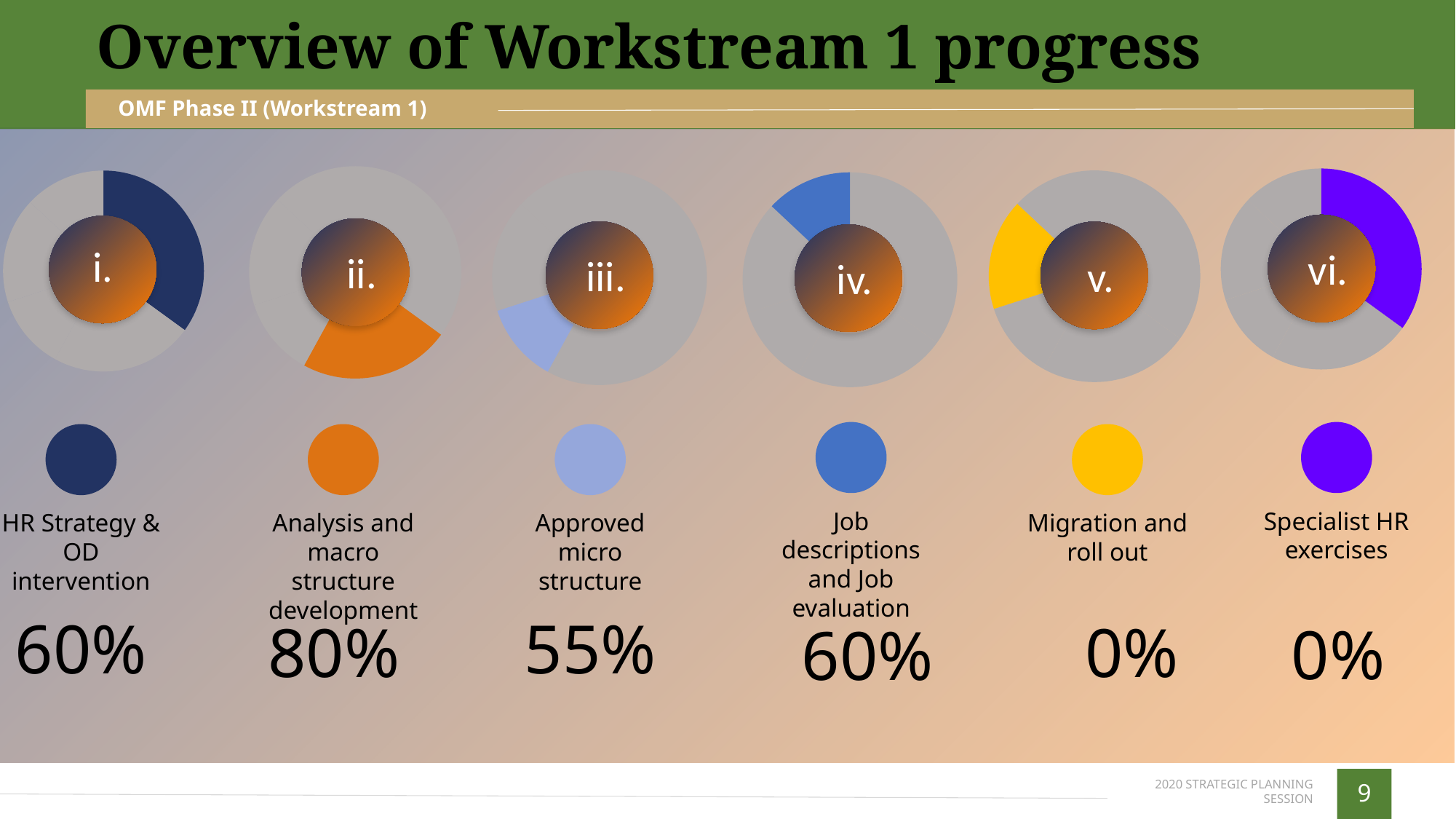
What colour is the marker for Migration and roll out? Yellow What progress percentage is shown for HR Strategy & OD intervention? 60% What progress percentage is shown for Analysis and macro structure development? 80% What progress percentage is shown for Migration and roll out? 0% What kind of chart is used to show each item's progress? Donut chart How many workstream items are shown on the slide? 6 Which workstream item has the highest progress percentage? Analysis and macro structure development What progress percentage is shown for Job descriptions and Job evaluation? 60% What is the difference between the progress percentages for Analysis and macro structure development and Approved micro structure? 25% Which has a higher progress percentage, HR Strategy & OD intervention or Approved micro structure? HR Strategy & OD intervention What progress percentage is shown for Approved micro structure? 55% How many items show a progress percentage of 0%? 2